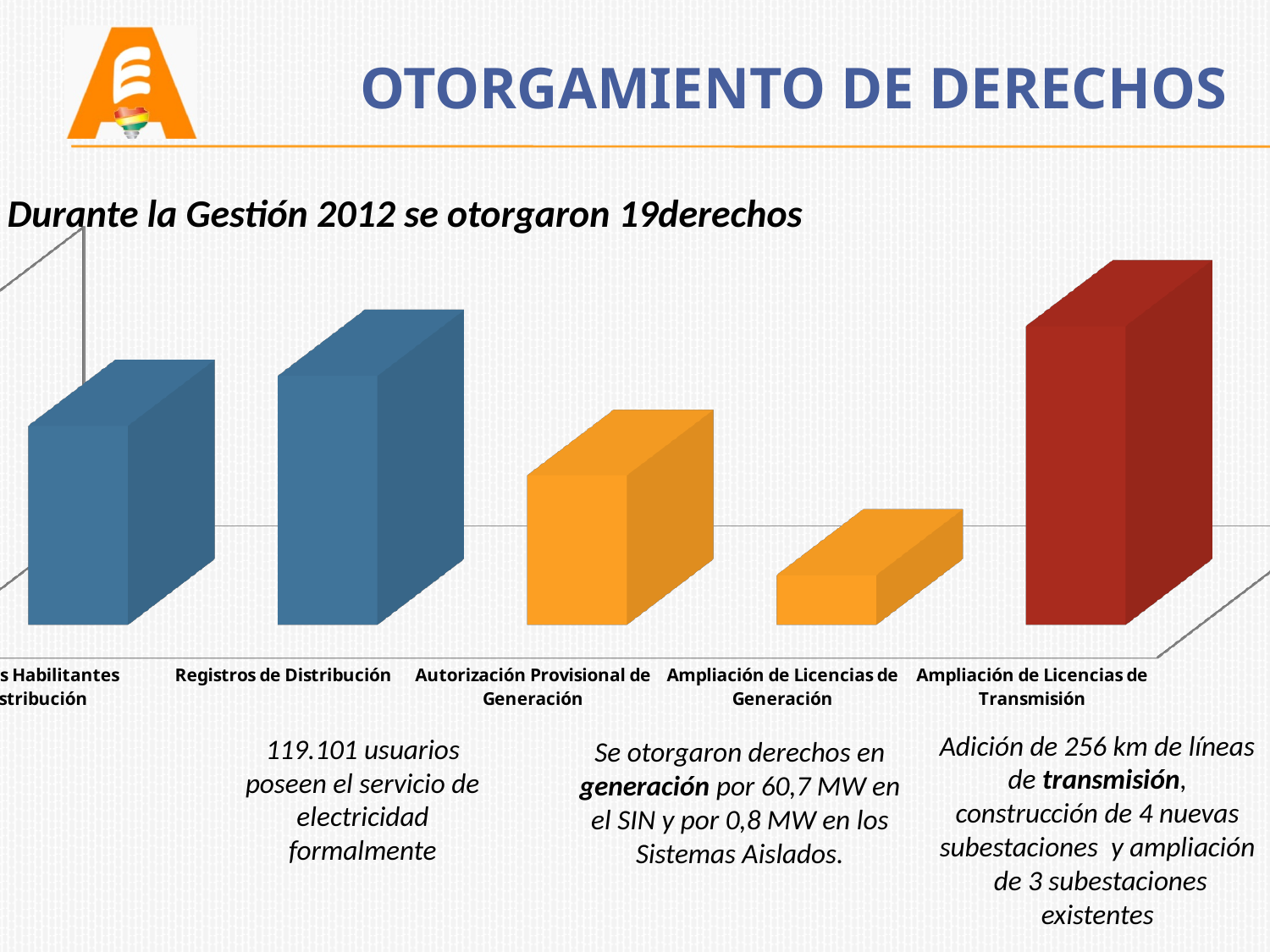
Does the bar height rise or fall from Autorización Provisional de Generación to Ampliación de Licencias de Generación? Fall According to the text above the chart, how many derechos were granted during the Gestión 2012? 19 What kind of chart is shown on the slide? Bar chart How many bars does the chart show? 5 Which is larger, the bar for Registros de Distribución or the bar for Ampliación de Licencias de Transmisión? Ampliación de Licencias de Transmisión Which is larger, the bar for Registros de Distribución or the bar for Autorización Provisional de Generación? Registros de Distribución Which is larger, the bar for Autorización Provisional de Generación or the bar for Ampliación de Licencias de Generación? Autorización Provisional de Generación What colour is the bar for Ampliación de Licencias de Transmisión? Red Which category has the tallest bar in the chart? Ampliación de Licencias de Transmisión Which category has the shortest bar in the chart? Ampliación de Licencias de Generación